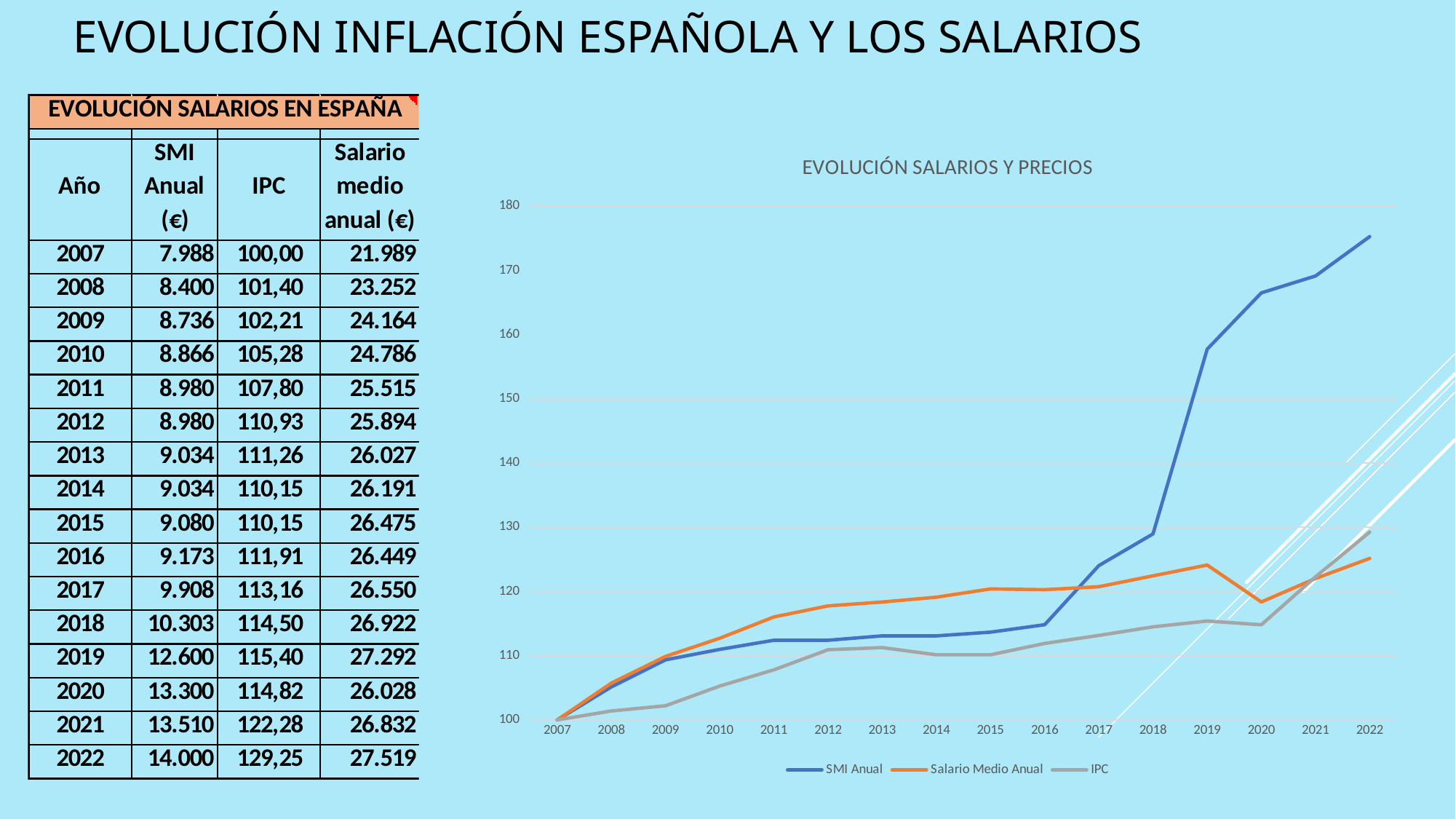
What is the title of the line chart on the slide? EVOLUCIÓN SALARIOS Y PRECIOS In the "EVOLUCIÓN SALARIOS Y PRECIOS" chart, which is higher in 2016: SMI Anual or Salario Medio Anual? Salario Medio Anual In the "EVOLUCIÓN SALARIOS Y PRECIOS" chart, is the value of Salario Medio Anual in 2022 greater or less than 130? less In the "EVOLUCIÓN SALARIOS Y PRECIOS" chart, is the value of IPC in 2020 greater or less than 120? less How many years are plotted along the x axis of the "EVOLUCIÓN SALARIOS Y PRECIOS" chart? 16 In the "EVOLUCIÓN SALARIOS Y PRECIOS" chart, does the SMI Anual line rise or fall from 2007 to 2022? rise In the "EVOLUCIÓN SALARIOS Y PRECIOS" chart, which series reaches the highest value in 2022? SMI Anual How many series does the legend of the "EVOLUCIÓN SALARIOS Y PRECIOS" chart list? 3 In the "EVOLUCIÓN SALARIOS Y PRECIOS" chart, is the value of SMI Anual in 2019 greater or less than 150? greater In the "EVOLUCIÓN SALARIOS Y PRECIOS" chart, which is higher in 2012: Salario Medio Anual or IPC? Salario Medio Anual What kind of chart is "EVOLUCIÓN SALARIOS Y PRECIOS"? line chart